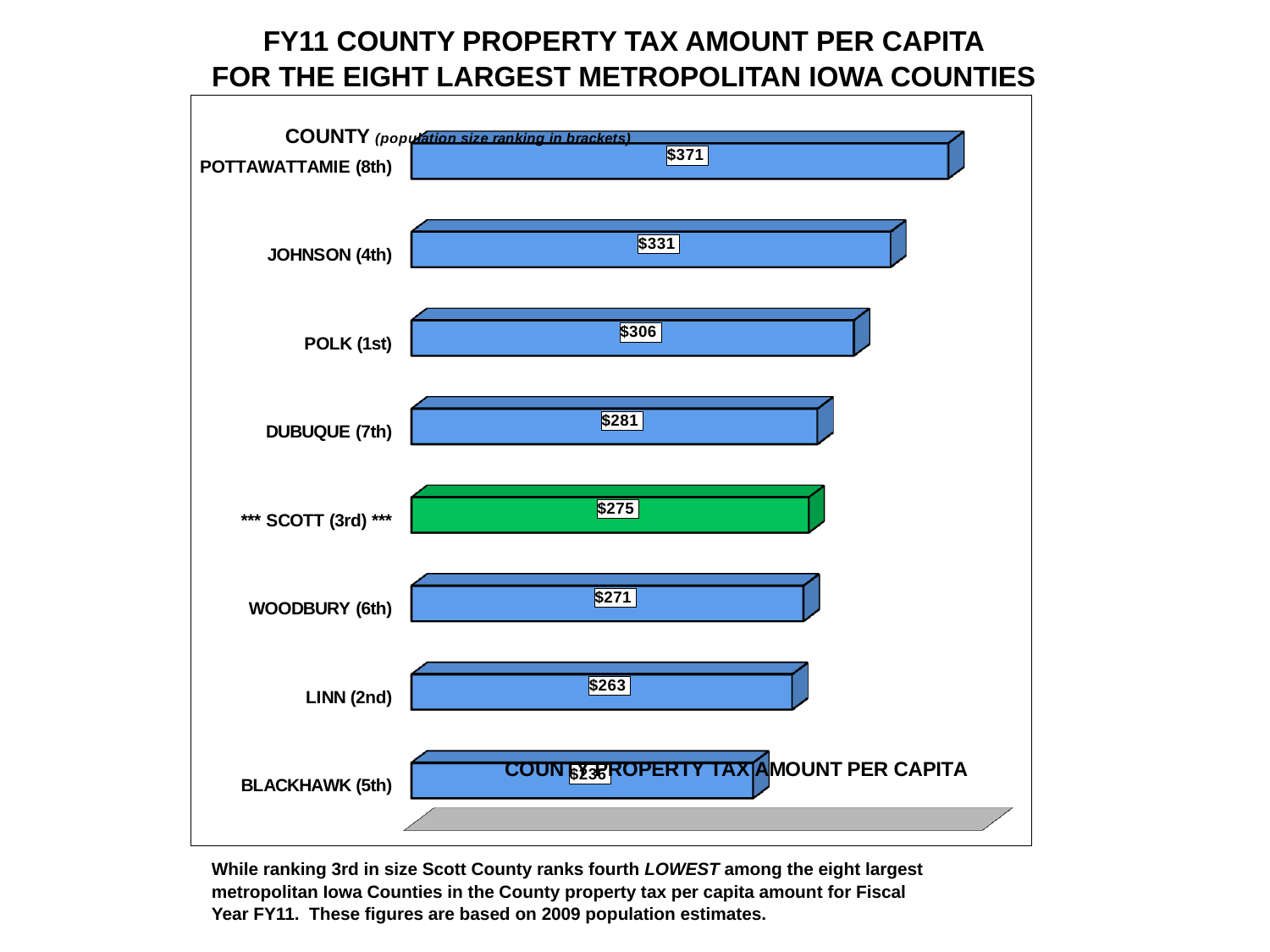
Which county has the highest property tax amount per capita? Pottawattamie (8th) How many counties are shown in the chart? 8 What type of chart is shown on the slide? Bar chart What is the difference between the per capita amounts for Dubuque (7th) and Scott (3rd)? $6 Which has a larger per capita amount, Polk (1st) or Woodbury (6th)? Polk (1st) What is the county property tax amount per capita for Johnson (4th)? $331 What is the county property tax amount per capita for Pottawattamie (8th)? $371 What is the county property tax amount per capita for Polk (1st)? $306 Which county has the lowest property tax amount per capita? Blackhawk (5th) What is the county property tax amount per capita for Linn (2nd)? $263 What is the difference between the per capita amounts for Pottawattamie (8th) and Johnson (4th)? $40 What is the county property tax amount per capita for Scott (3rd)? $275